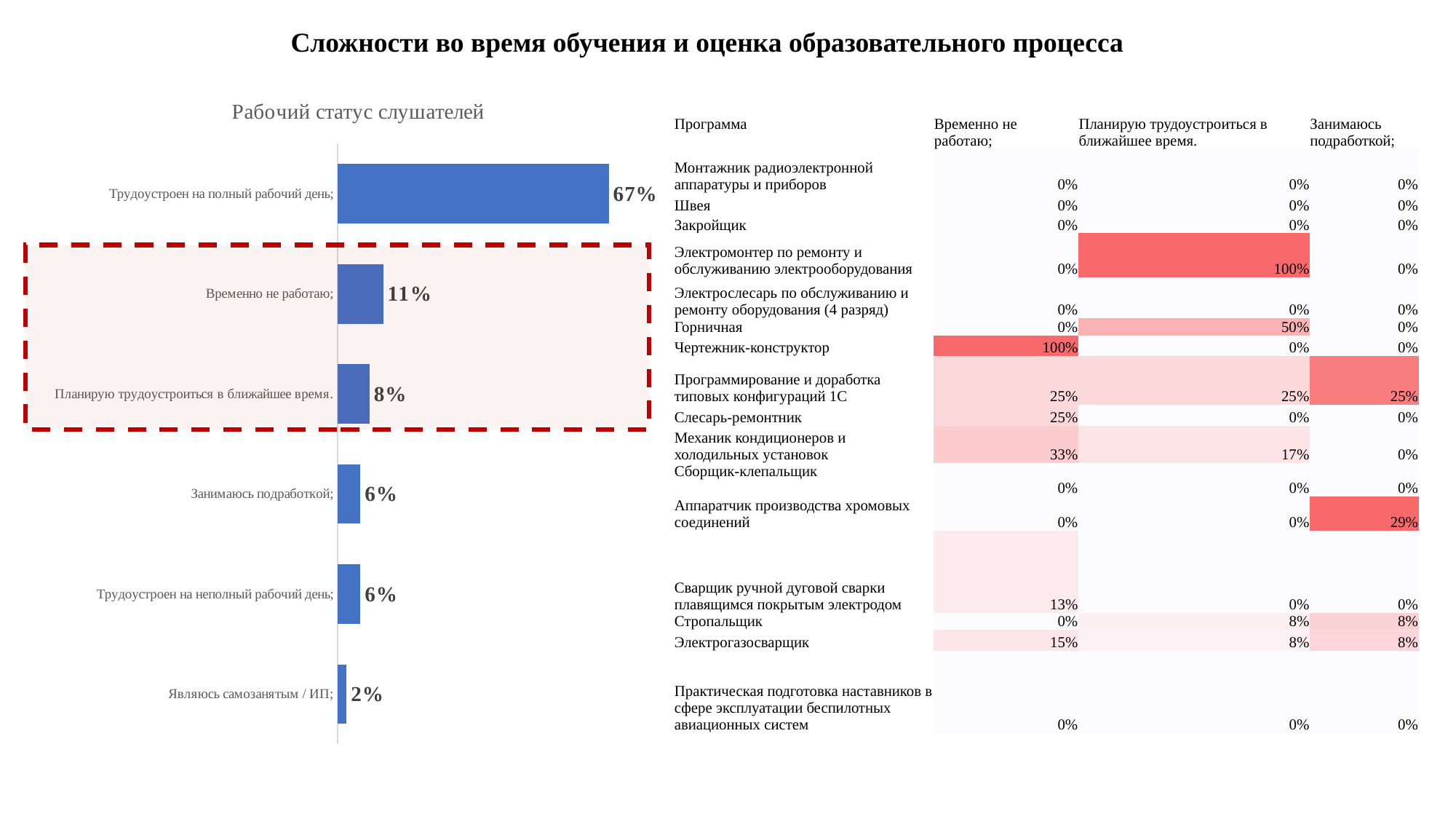
In the chart 'Рабочий статус слушателей', what is the value for 'Планирую трудоустроиться в ближайшее время'? 8% In the chart 'Рабочий статус слушателей', what is the value for 'Временно не работаю'? 11% In the chart 'Рабочий статус слушателей', which category has the lowest value? Являюсь самозанятым / ИП How many categories are shown in the chart 'Рабочий статус слушателей'? 6 In the chart 'Рабочий статус слушателей', what is the value for 'Являюсь самозанятым / ИП'? 2% What is the title of the bar chart on the left of the slide? Рабочий статус слушателей In the chart 'Рабочий статус слушателей', what is the difference between 'Временно не работаю' and 'Планирую трудоустроиться в ближайшее время'? 3% In the chart 'Рабочий статус слушателей', which is larger: 'Занимаюсь подработкой' or 'Являюсь самозанятым / ИП'? Занимаюсь подработкой In the chart 'Рабочий статус слушателей', what is the value for 'Трудоустроен на полный рабочий день'? 67% What type of chart is 'Рабочий статус слушателей'? Bar chart In the chart 'Рабочий статус слушателей', what is the difference between 'Трудоустроен на полный рабочий день' and 'Временно не работаю'? 56% In the chart 'Рабочий статус слушателей', which category has the highest value? Трудоустроен на полный рабочий день